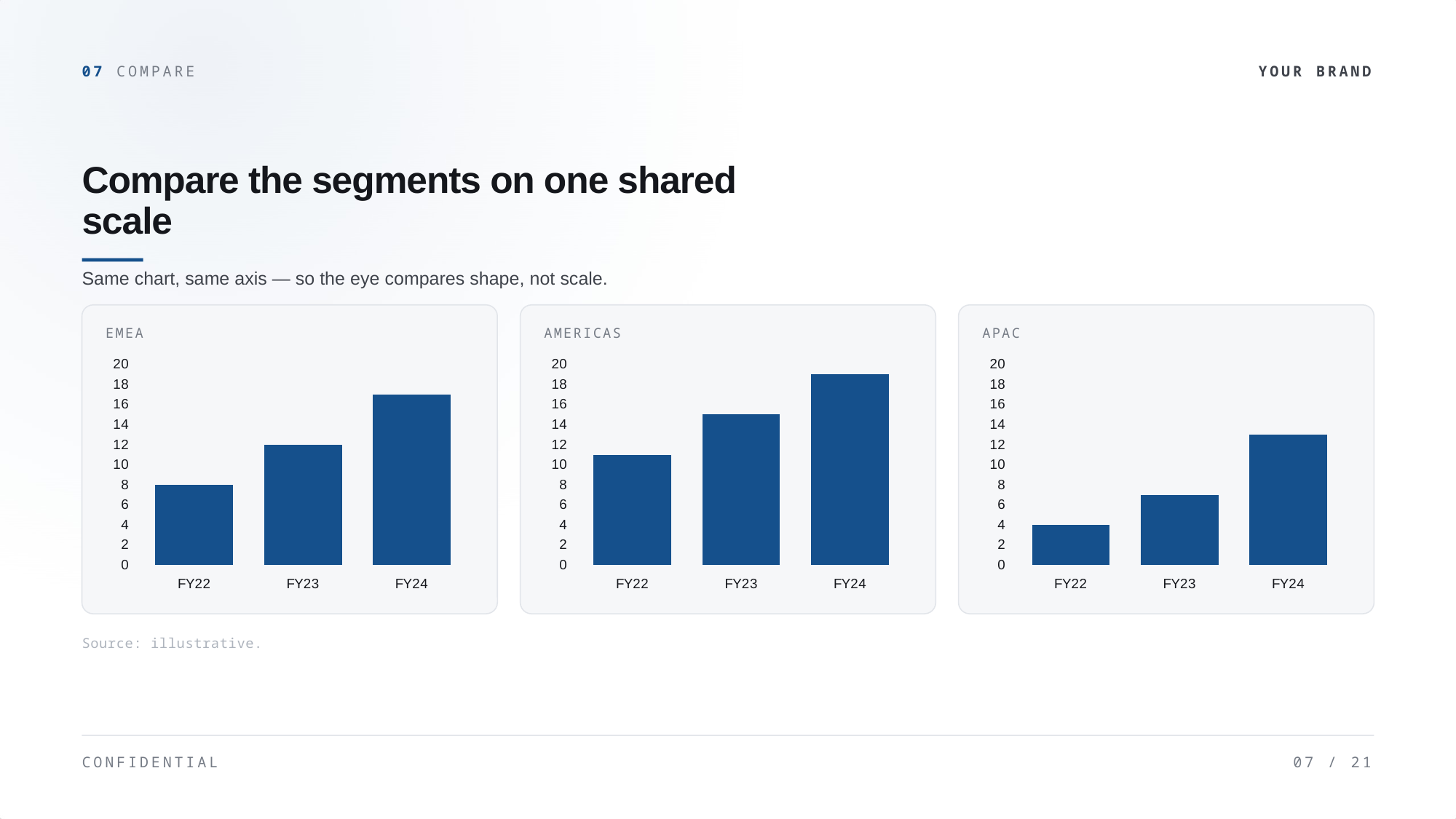
How many categories are shown on the x axis of the APAC chart? 3 In the AMERICAS chart, is the value for FY22 greater or less than 10? greater In the EMEA chart, what is the value for FY22? 8 In the APAC chart, what is the value for FY22? 4 In the EMEA chart, what is the value for FY23? 12 In the APAC chart, which fiscal year has the lowest value? FY22 In the EMEA chart, do the values rise or fall from FY22 to FY24? rise In the AMERICAS chart, is the value for FY24 greater or less than 18? greater What kind of chart is the AMERICAS chart? bar chart In the APAC chart, is the value for FY24 greater or less than 14? less In the EMEA chart, what is the difference between the FY23 and FY22 values? 4 In the AMERICAS chart, which fiscal year has the highest value? FY24